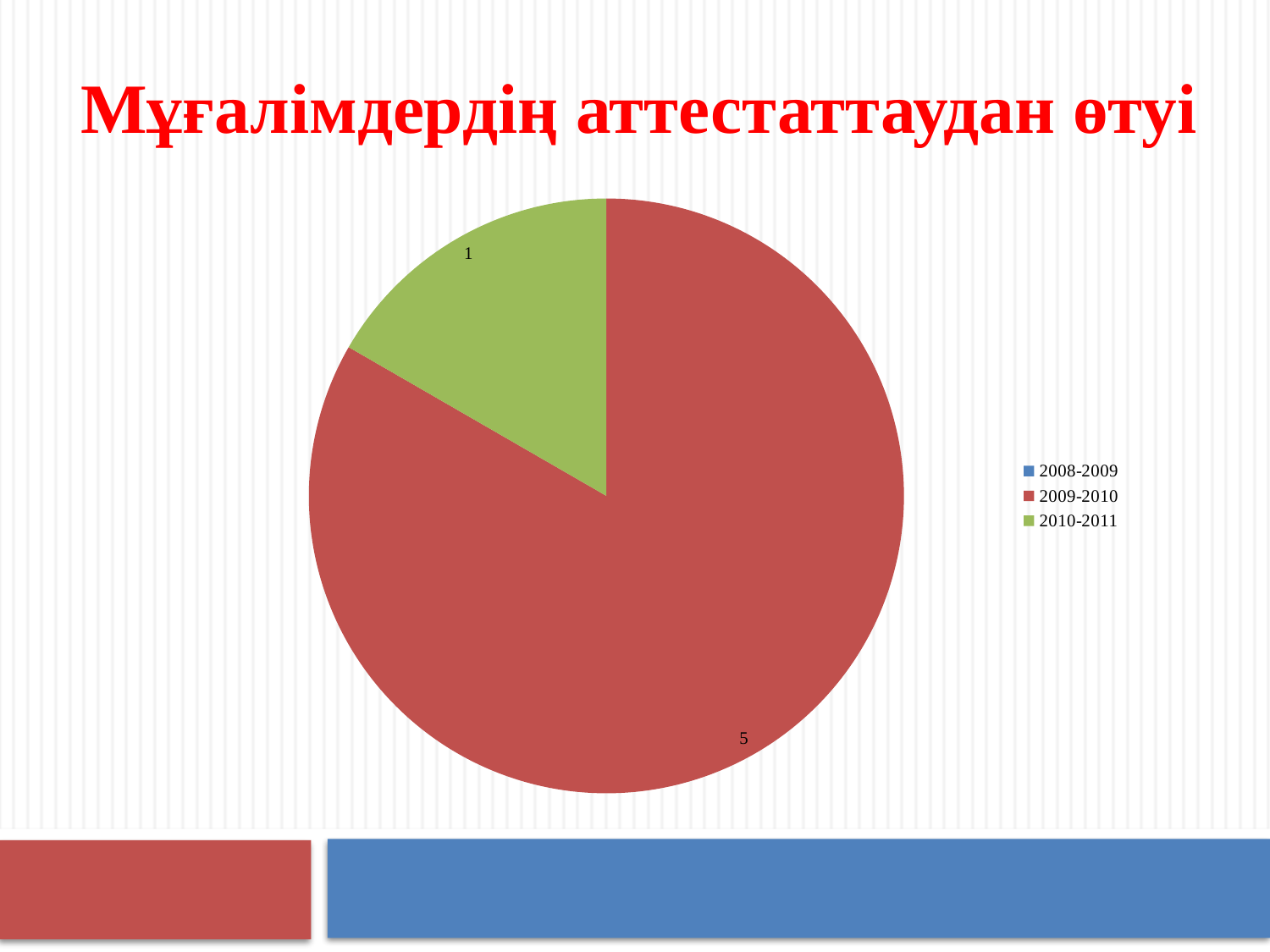
What is the value for 2010-2011 in the pie chart? 1 What is the value for 2009-2010 in the pie chart? 5 What colour is the slice for 2010-2011 in the pie chart? Green What is the difference between the values for 2009-2010 and 2010-2011? 4 How many slices with data labels are visible in the pie chart? 2 Which category has the largest slice in the pie chart? 2009-2010 What is the title of the slide containing the pie chart? Мұғалімдердің аттестаттаудан өтуі Which is larger, the value for 2009-2010 or the value for 2010-2011? 2009-2010 What is the total of the labelled values in the pie chart? 6 How many entries does the legend of the pie chart list? 3 What kind of chart is shown on the slide? Pie chart